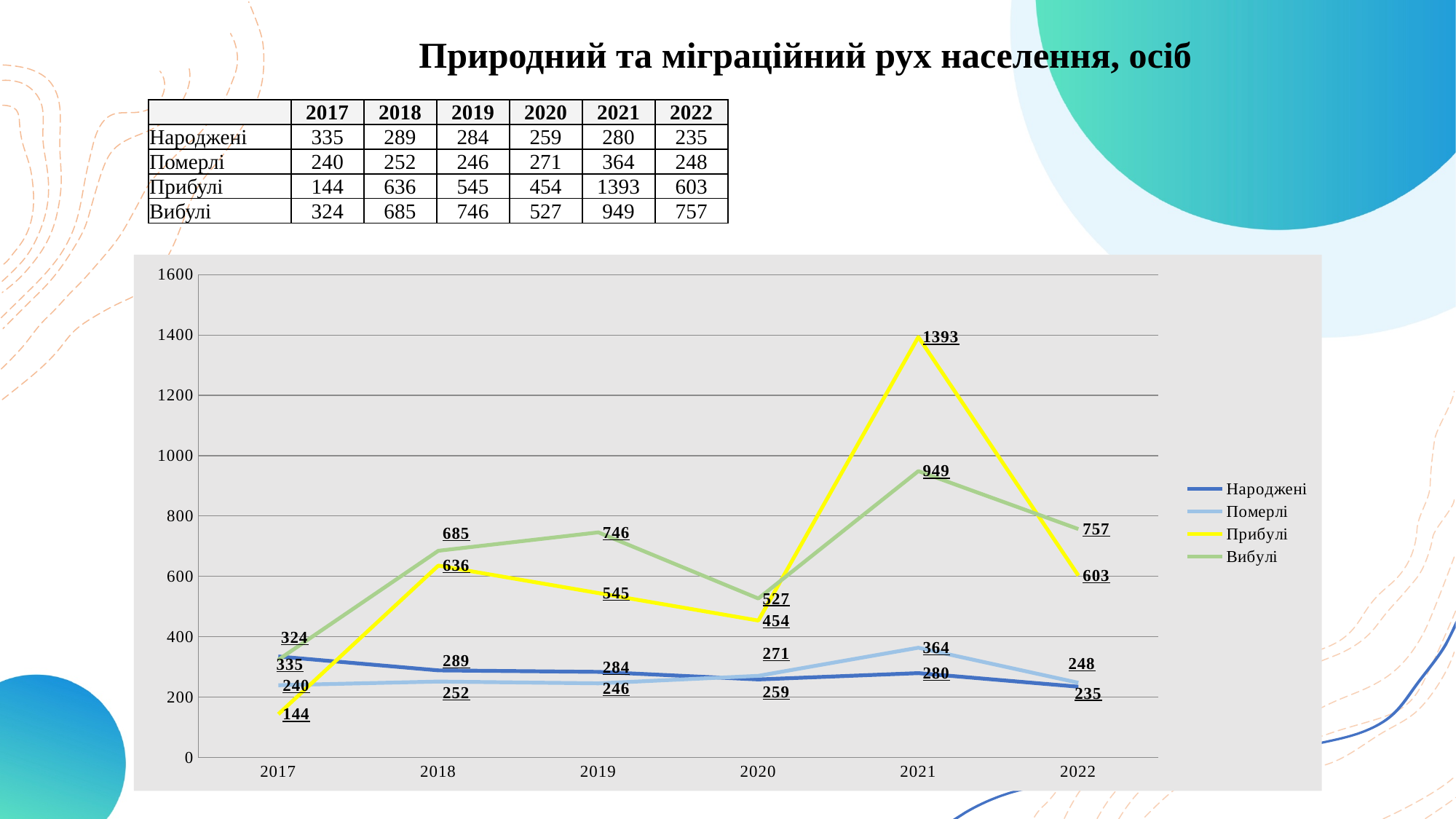
How many years are shown on the x axis of the chart? 6 Which is larger in 2021: Померлі or Народжені? Померлі What is the value for Народжені in 2022? 235 In which year is the value for Прибулі the lowest? 2017 Does the value for Народжені rise or fall from 2017 to 2022? fall In which year is the value for Вибулі the highest? 2021 What is the difference between Вибулі and Прибулі in 2022? 154 How many series does the chart legend list? 4 What is the value for Вибулі in 2019? 746 Which series is drawn in yellow on the chart? Прибулі What is the value for Прибулі in 2021? 1393 What type of chart is shown on the slide? line chart